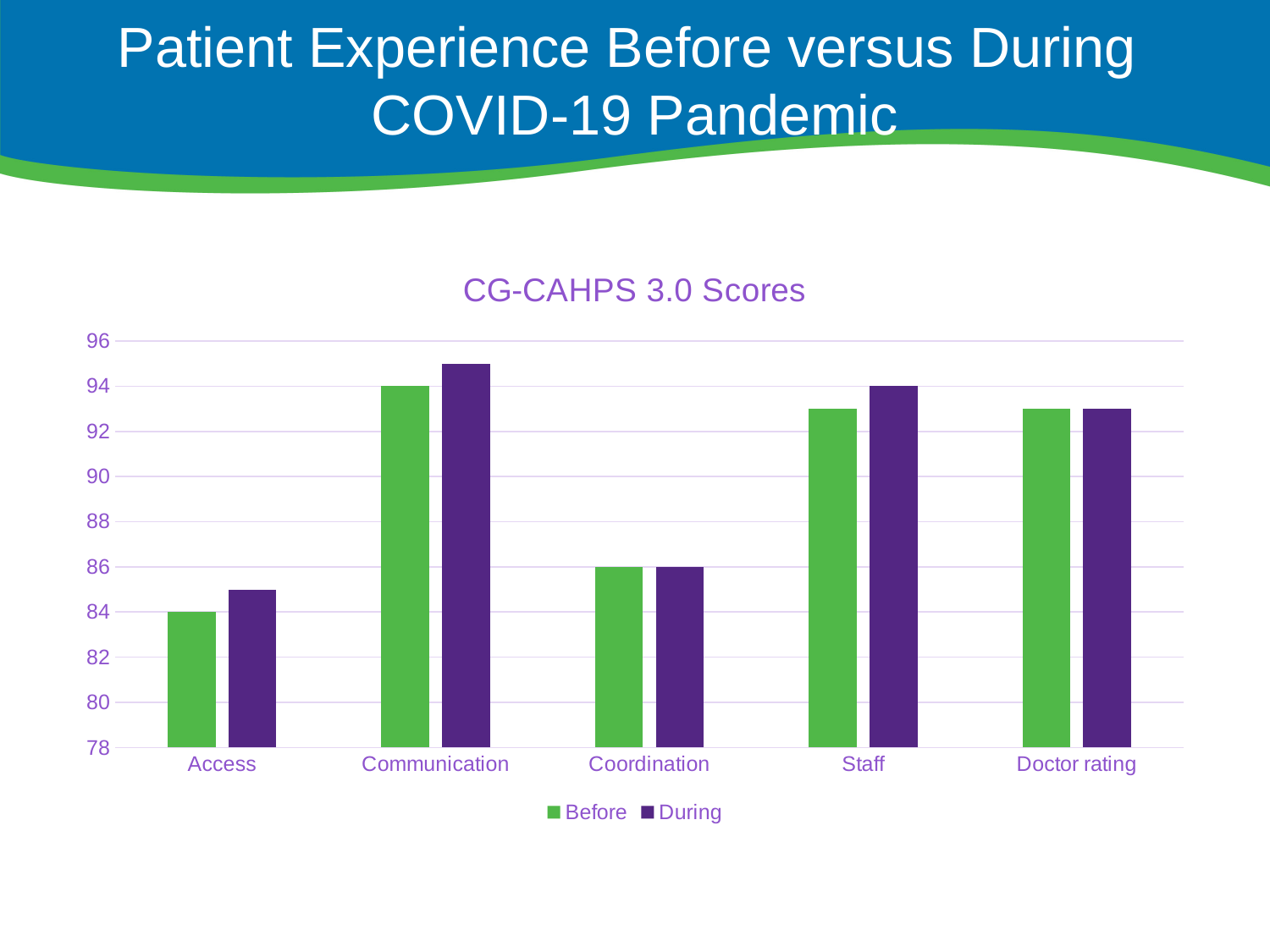
What is the During score for Staff? 94 Which category has the highest During score? Communication What is the During score for Coordination? 86 What is the Before score for Communication? 94 How many categories are shown on the x axis? 5 Which is larger, the Before score for Staff or the Before score for Coordination? Staff What is the Before score for Access? 84 Which category has the lowest Before score? Access What is the title of the chart? CG-CAHPS 3.0 Scores Is the During score for Communication greater or less than 94? greater How many series does the legend list? 2 What is the difference between the Before scores for Communication and Access? 10